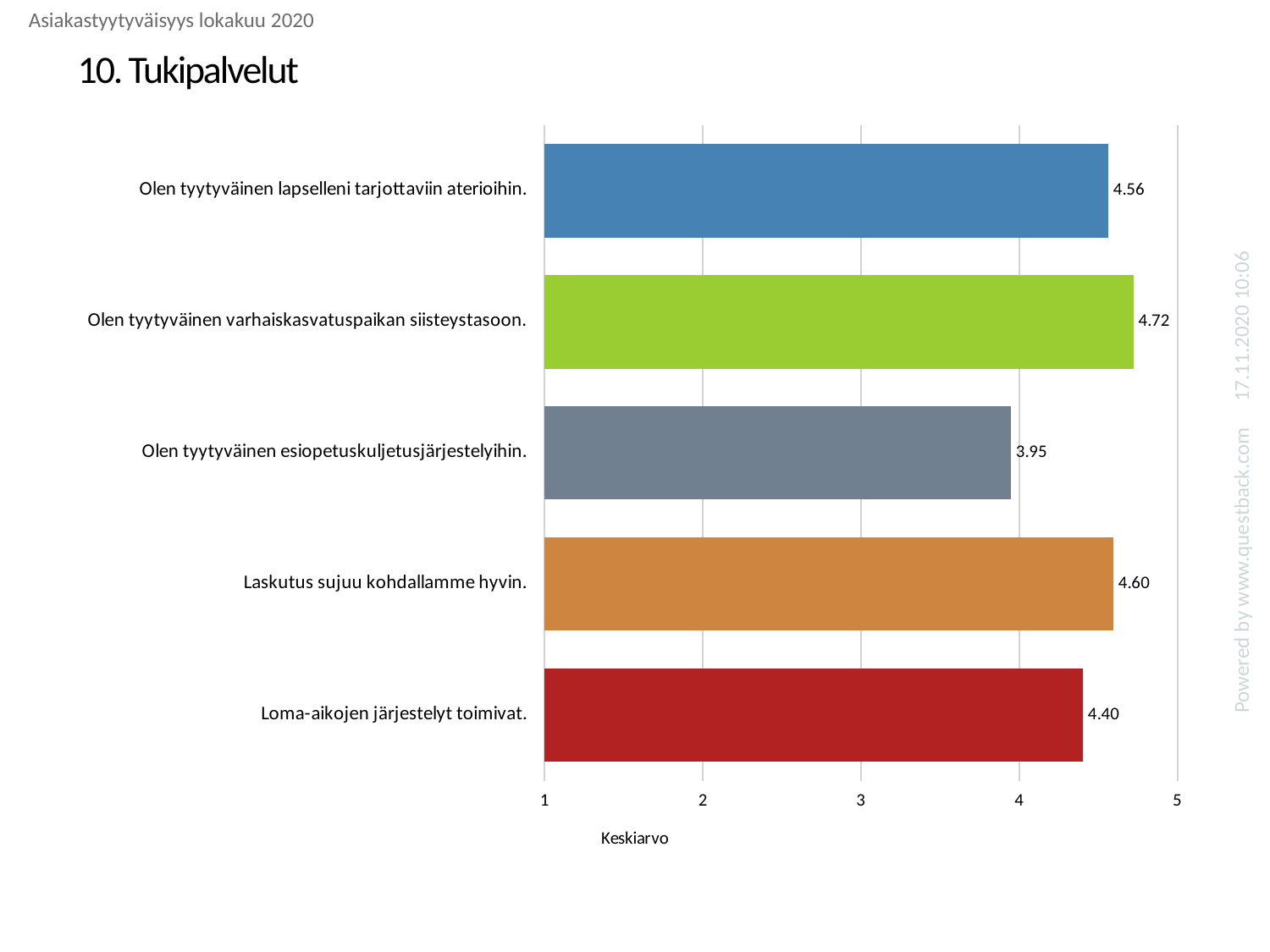
Which is larger: the value for "Laskutus sujuu kohdallamme hyvin." or the value for "Loma-aikojen järjestelyt toimivat."? Laskutus sujuu kohdallamme hyvin. Is the value for "Olen tyytyväinen esiopetuskuljetusjärjestelyihin." greater or less than 4? less Which category has the highest value? Olen tyytyväinen varhaiskasvatuspaikan siisteystasoon. What is the label of the horizontal axis? Keskiarvo What is the value for "Laskutus sujuu kohdallamme hyvin."? 4.60 What is the value for "Olen tyytyväinen lapselleni tarjottaviin aterioihin."? 4.56 Which category has the lowest value? Olen tyytyväinen esiopetuskuljetusjärjestelyihin. What is the difference between the values for "Olen tyytyväinen varhaiskasvatuspaikan siisteystasoon." and "Olen tyytyväinen esiopetuskuljetusjärjestelyihin."? 0.77 What kind of chart is shown on the slide? bar chart What is the value for "Olen tyytyväinen esiopetuskuljetusjärjestelyihin."? 3.95 How many categories are shown in the chart? 5 What is the value for "Loma-aikojen järjestelyt toimivat."? 4.40